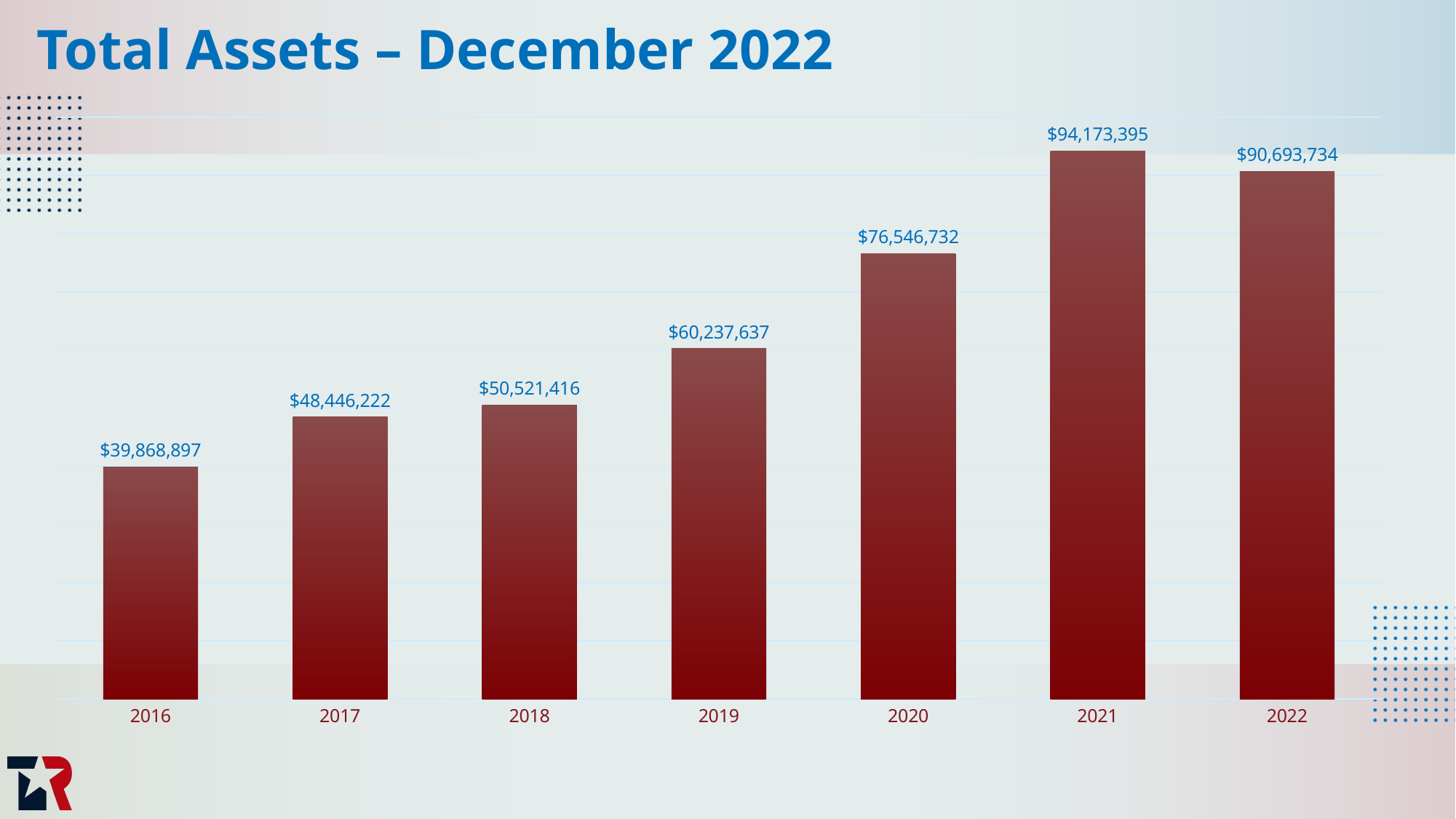
Which year has the highest total assets? 2021 How many years are shown on the x axis? 7 What is the value for 2022? $90,693,734 What is the difference between the values for 2017 and 2016? $8,577,325 What is the difference between the values for 2021 and 2022? $3,479,661 Which year has the lowest total assets? 2016 What is the title of the chart? Total Assets – December 2022 Which is larger, the value for 2020 or the value for 2019? 2020 What is the value for 2019? $60,237,637 What kind of chart is shown on the slide? Bar chart Do the values rise or fall from 2016 to 2021? Rise What is the value for 2016? $39,868,897